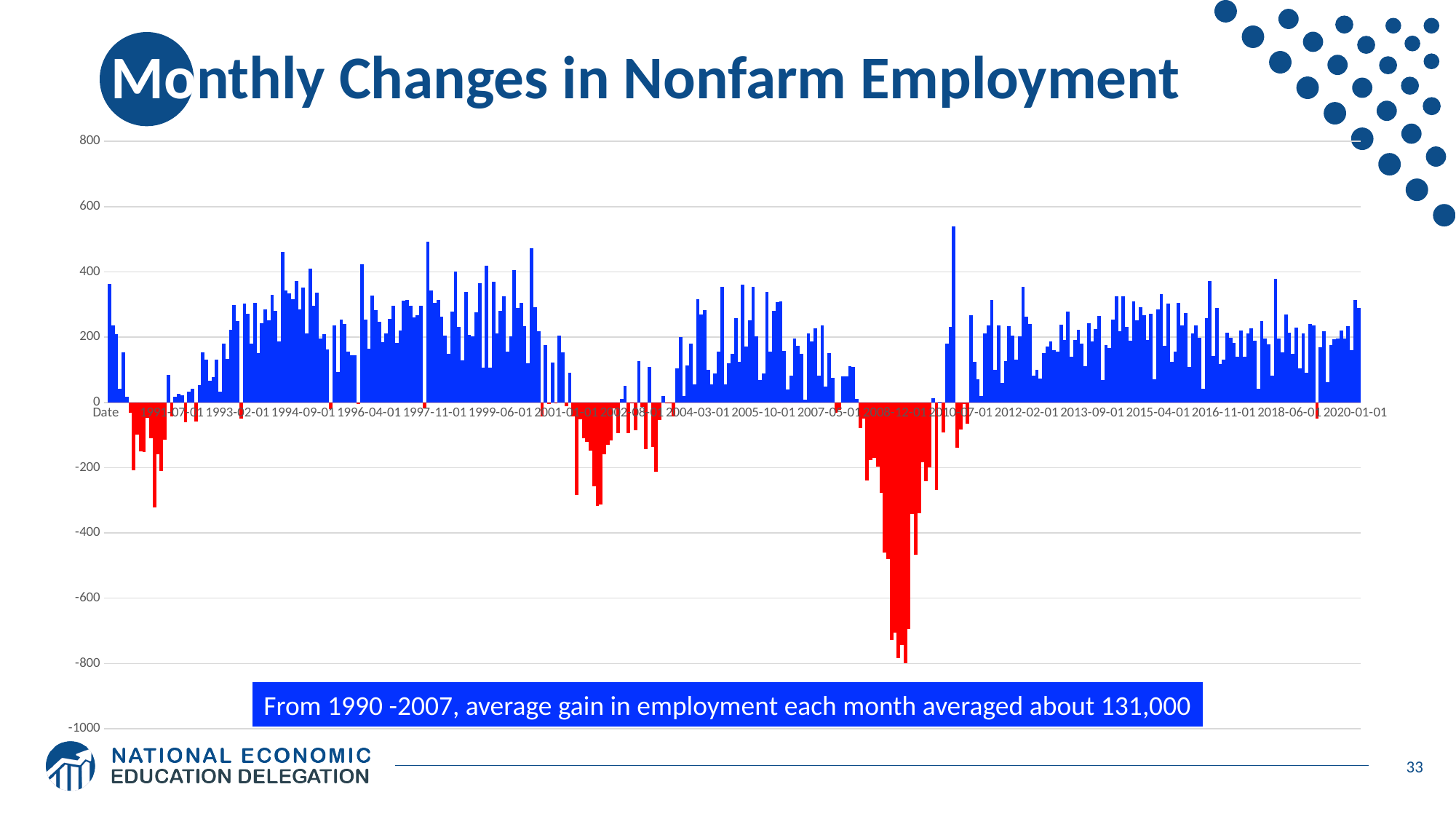
Is the lowest monthly change, the deepest red bar around 2008-12-01 to 2010, greater or less than -600? less According to the text box on the chart, what was the average monthly employment gain from 1990-2007? about 131,000 What kind of chart is shown on the slide? bar chart Which period shows the larger monthly job loss: the red bars around 2008-12-01 or the red bars around 2001-2002? around 2008-12-01 Is the deepest red bar in the 2001-2002 period greater or less than -200? less Is the deepest red bar in the early 1990s (around 1991) greater or less than -200? less What colour are the bars representing negative monthly changes? red